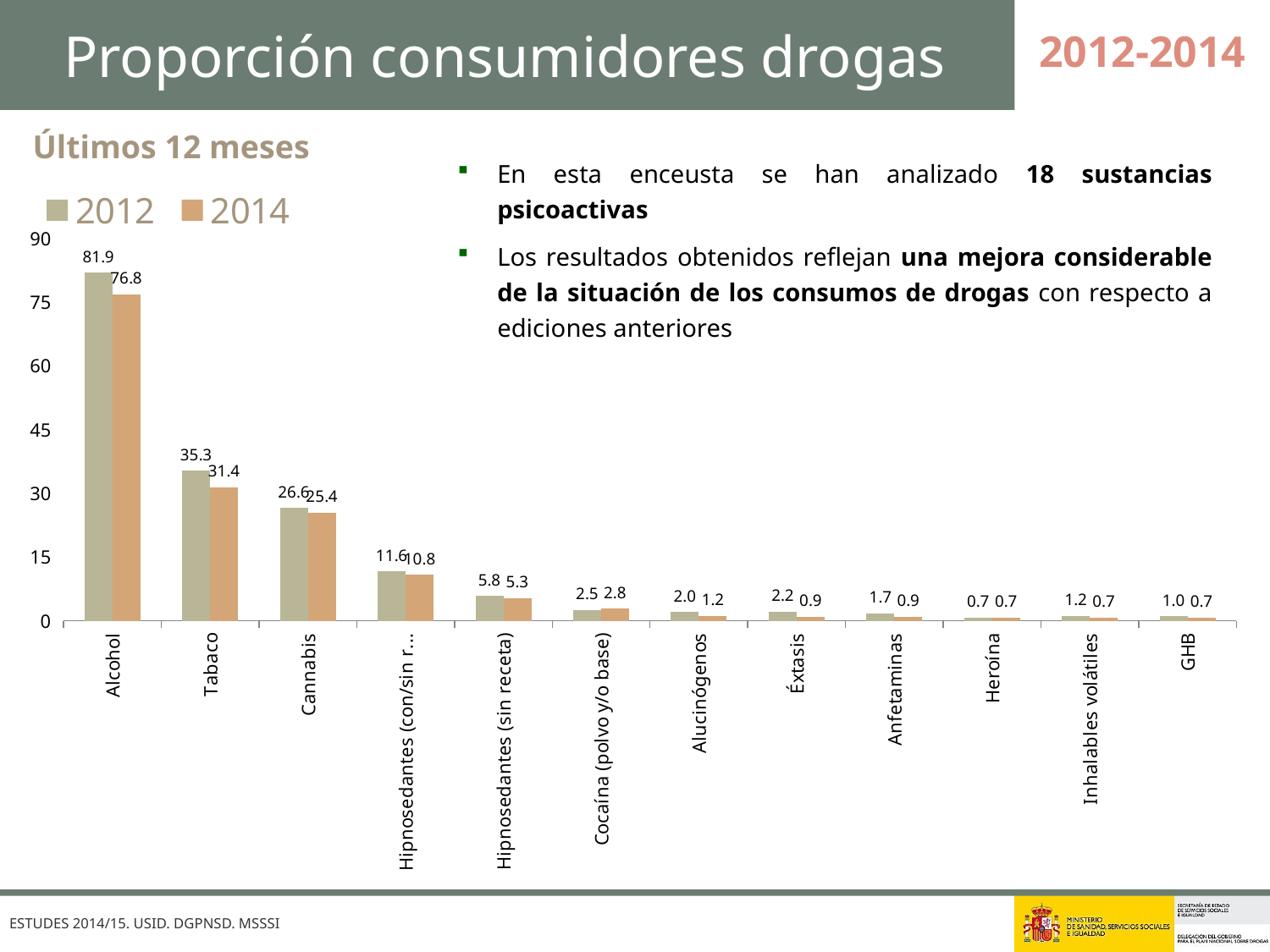
Which category has the lowest 2012 value? Heroína What is the 2012 value for Hipnosedantes (sin receta)? 5.8 What is the 2014 value for Tabaco? 31.4 What kind of chart is shown on the slide? Bar chart How many series does the legend list? 2 For Cocaína (polvo y/o base), which year has the larger value, 2012 or 2014? 2014 What is the difference between the 2012 and 2014 values for Alcohol? 5.1 What is the 2014 value for Cannabis? 25.4 What is the 2012 value for Alcohol? 81.9 How many categories are shown on the x axis? 12 Which category has the highest 2014 value? Alcohol What is the difference between the 2012 and 2014 values for Tabaco? 3.9